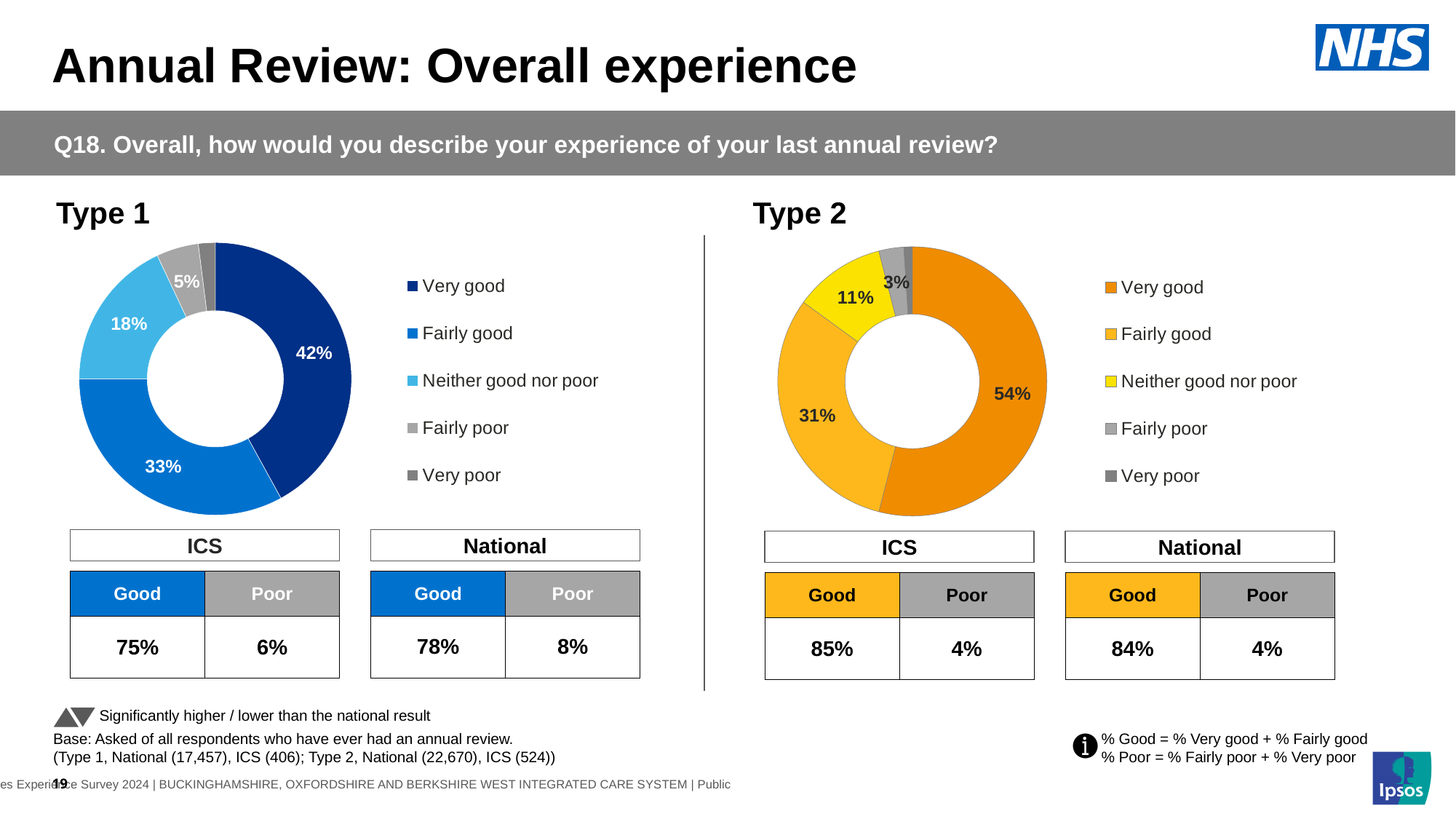
In the Type 2 chart, which category has the largest share? Very good In the Type 2 chart, what colour represents Neither good nor poor? Yellow In the Type 1 chart, which category has the smallest share? Very poor In the Type 1 chart, what percentage is shown for Neither good nor poor? 18% Which is larger: the Very good share in the Type 1 chart or the Very good share in the Type 2 chart? Type 2 How many categories does the legend of the Type 1 chart list? 5 What kind of chart is used for Type 2? Pie chart (donut) In the Type 1 chart, what is the difference in percentage points between Very good and Fairly good? 9 percentage points In the Type 1 chart, what percentage of respondents said their experience was Very good? 42% In the Type 2 chart, what percentage is shown for Fairly poor? 3% In the Type 2 chart, what is the difference in percentage points between Very good and Neither good nor poor? 43 percentage points In the Type 2 chart, what percentage of respondents said their experience was Fairly good? 31%